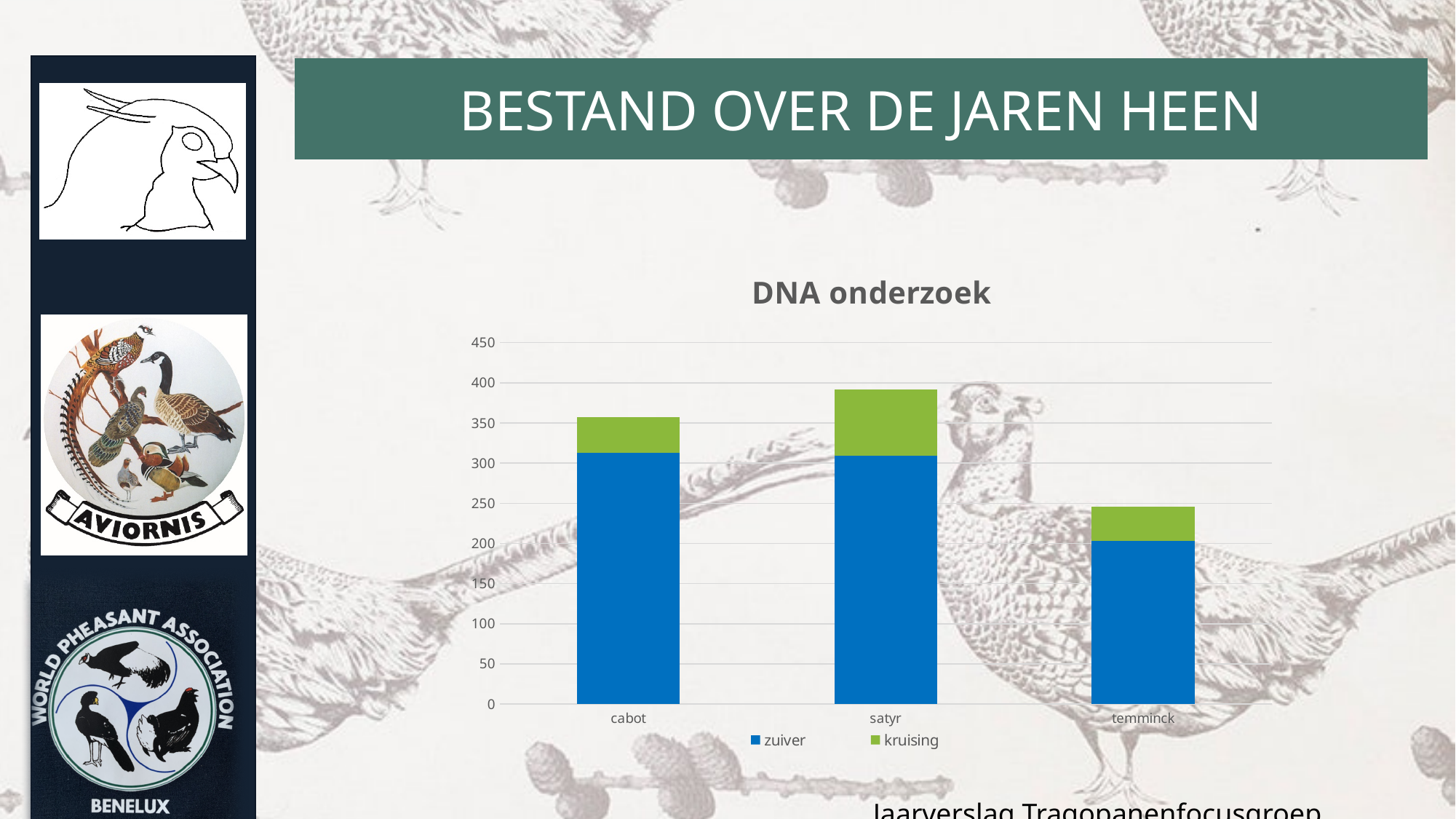
Is the total stacked bar for temminck greater or less than 200? greater Which category has the shortest stacked bar in the "DNA onderzoek" chart? temminck Is the "kruising" value for satyr larger or smaller than the "kruising" value for cabot? larger Which category has the largest "kruising" value in the "DNA onderzoek" chart? satyr How many series does the legend of the "DNA onderzoek" chart list? 2 What kind of chart is shown under the title "DNA onderzoek"? stacked bar chart Which category has the tallest stacked bar in the "DNA onderzoek" chart? satyr Which category has the smallest "zuiver" value in the "DNA onderzoek" chart? temminck Is the total stacked bar for satyr greater or less than 400? less Which colour represents the "zuiver" series in the "DNA onderzoek" chart? blue Is the "zuiver" value for cabot greater or less than 300? greater How many categories are shown on the x axis of the "DNA onderzoek" chart? 3